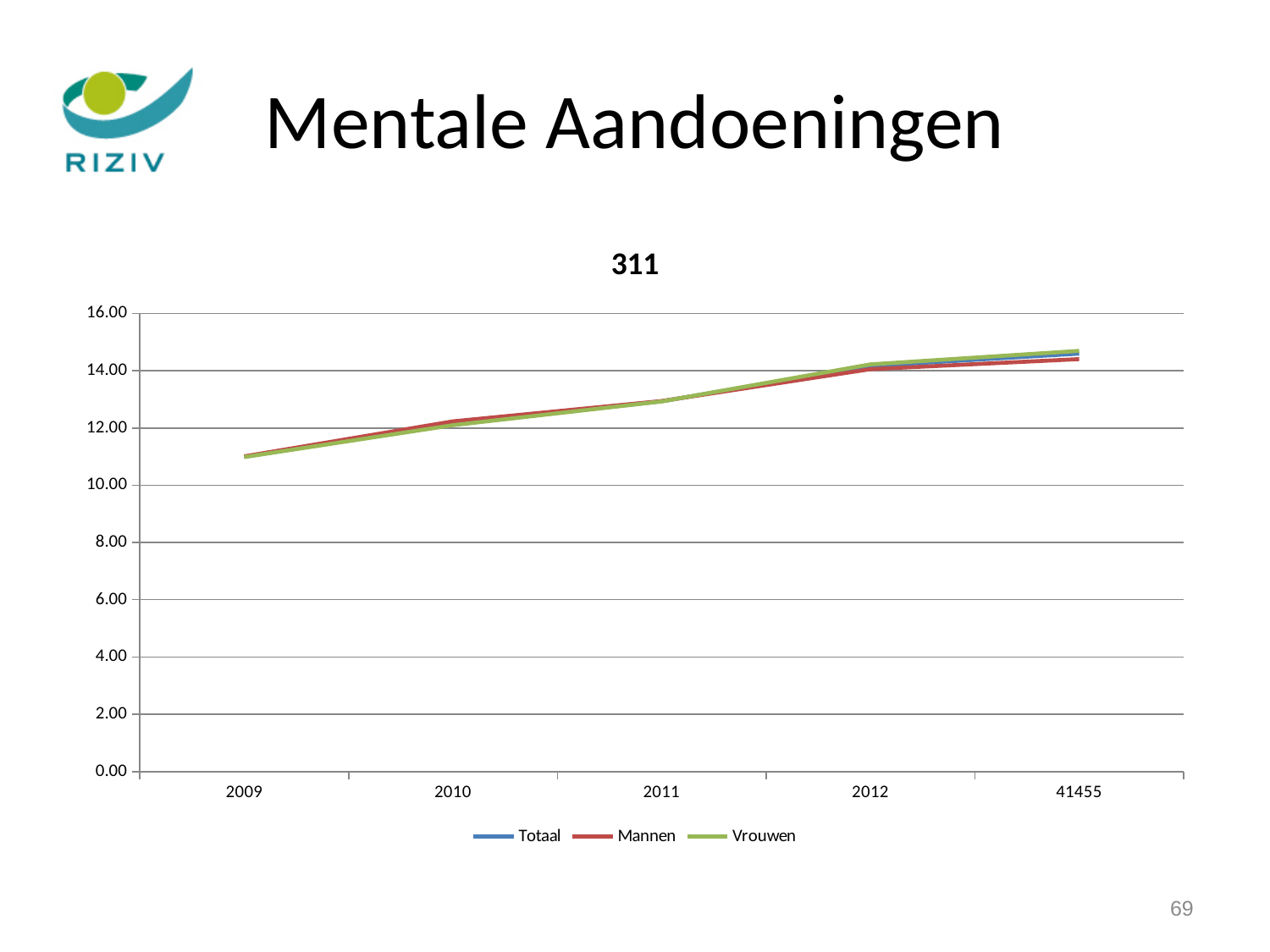
What kind of chart is shown on the slide? line chart Which series are listed in the legend? Totaal, Mannen, Vrouwen How many points are plotted along the x axis? 5 Is the value for Vrouwen in 2012 greater or less than 14.00? greater Do the values for Totaal rise or fall from 2009 to the last point on the x axis? rise How many series does the legend list? 3 Is the value for Mannen in 2009 greater or less than 12.00? less Is the value for Vrouwen at the last x-axis point (41455) greater or less than 16.00? less Is the value for Totaal in 2012 larger than the value for Totaal in 2009? yes In which year is the value for Mannen lowest? 2009 What is the title of the chart? 311